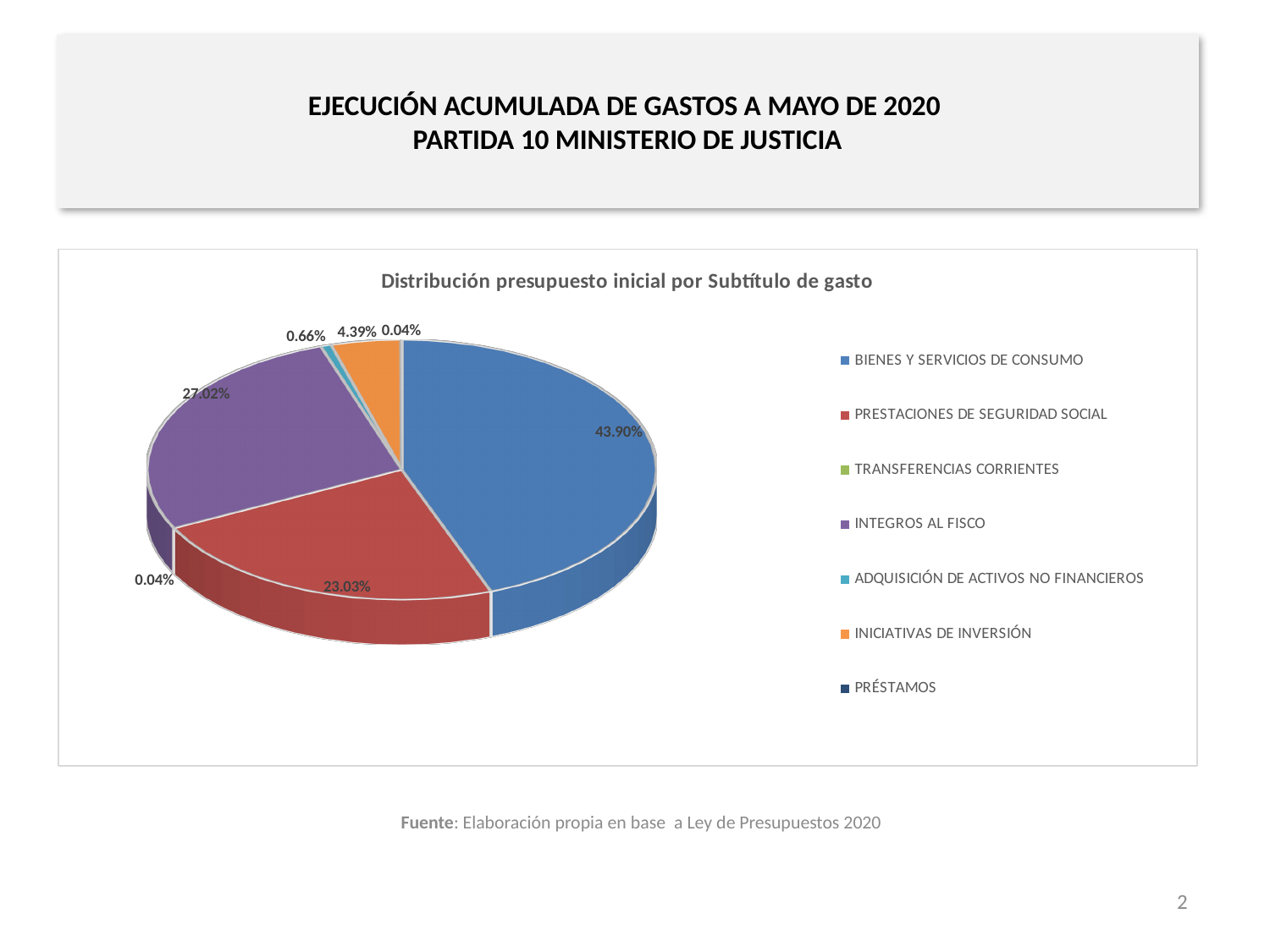
What share of the pie does BIENES Y SERVICIOS DE CONSUMO represent? 43.90% What share of the pie does INTEGROS AL FISCO represent? 27.02% What share of the pie does INICIATIVAS DE INVERSIÓN represent? 4.39% What is the title of the chart? Distribución presupuesto inicial por Subtítulo de gasto Which category has the largest share of the pie? BIENES Y SERVICIOS DE CONSUMO Which has a larger share, INTEGROS AL FISCO or PRESTACIONES DE SEGURIDAD SOCIAL? INTEGROS AL FISCO What is the difference in percentage points between INTEGROS AL FISCO and PRESTACIONES DE SEGURIDAD SOCIAL? 3.99 percentage points What is the difference in percentage points between BIENES Y SERVICIOS DE CONSUMO and INTEGROS AL FISCO? 16.88 percentage points How many categories does the legend list? 7 What share of the pie does ADQUISICIÓN DE ACTIVOS NO FINANCIEROS represent? 0.66% What kind of chart is shown on the slide? Pie chart What share of the pie does PRESTACIONES DE SEGURIDAD SOCIAL represent? 23.03%